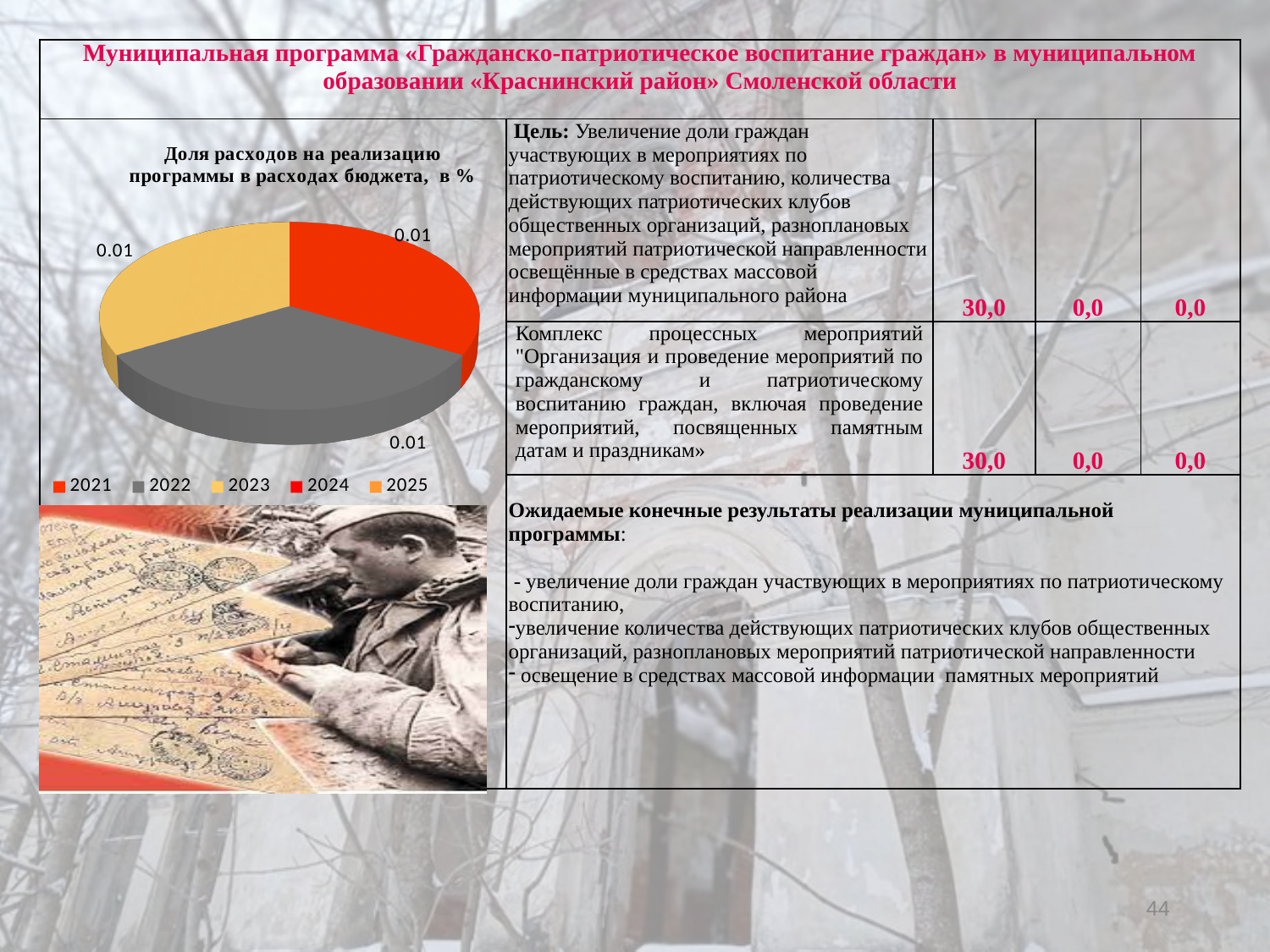
Which legend entry is shown in gray in the pie chart? 2022 What value is labelled on the 2023 slice of the pie chart? 0.01 What is the total of the three labelled slices in the pie chart? 0.03 What value is labelled on the 2021 slice of the pie chart? 0.01 How many slices with data labels are visible in the pie chart? 3 What is the difference between the labelled values for 2021 and 2022 in the pie chart? 0 What value is labelled on the 2022 slice of the pie chart? 0.01 What kind of chart is shown on the slide? pie chart What is the title of the pie chart? Доля расходов на реализацию программы в расходах бюджета, в % How many entries does the legend of the pie chart list? 5